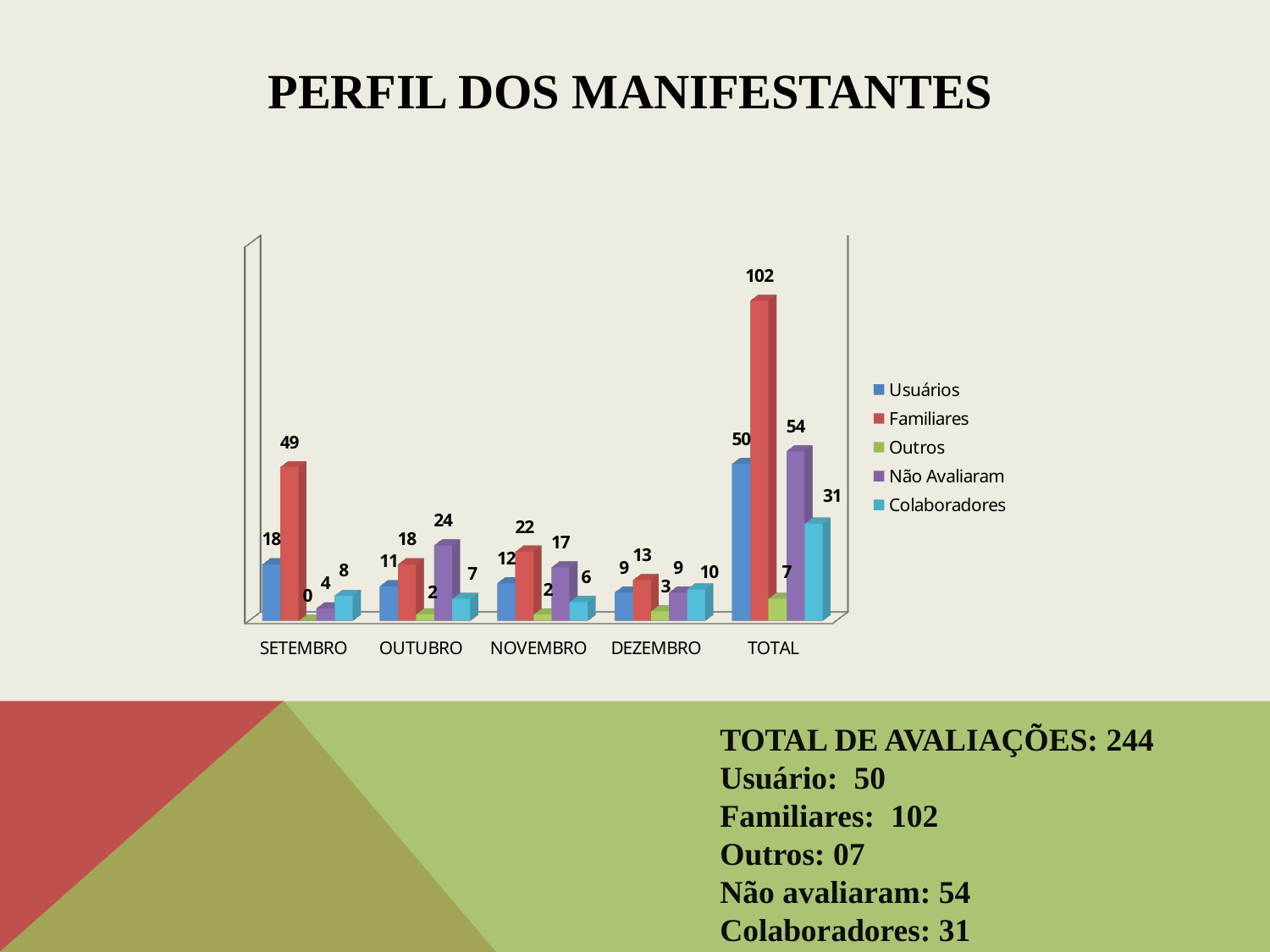
What is the value for Colaboradores in TOTAL? 31 What is the difference between Familiares and Usuários in TOTAL? 52 What is the value for Outros in DEZEMBRO? 3 Which is larger in NOVEMBRO, Familiares or Não Avaliaram? Familiares What is the value for Familiares in SETEMBRO? 49 Which month has the highest value for Familiares (excluding TOTAL)? SETEMBRO What is the title of the slide containing the chart? PERFIL DOS MANIFESTANTES What kind of chart is shown on the slide? Bar chart Which month has the lowest value for Usuários (excluding TOTAL)? DEZEMBRO How many categories are shown on the x axis? 5 How many series does the legend list? 5 What is the value for Não Avaliaram in OUTUBRO? 24